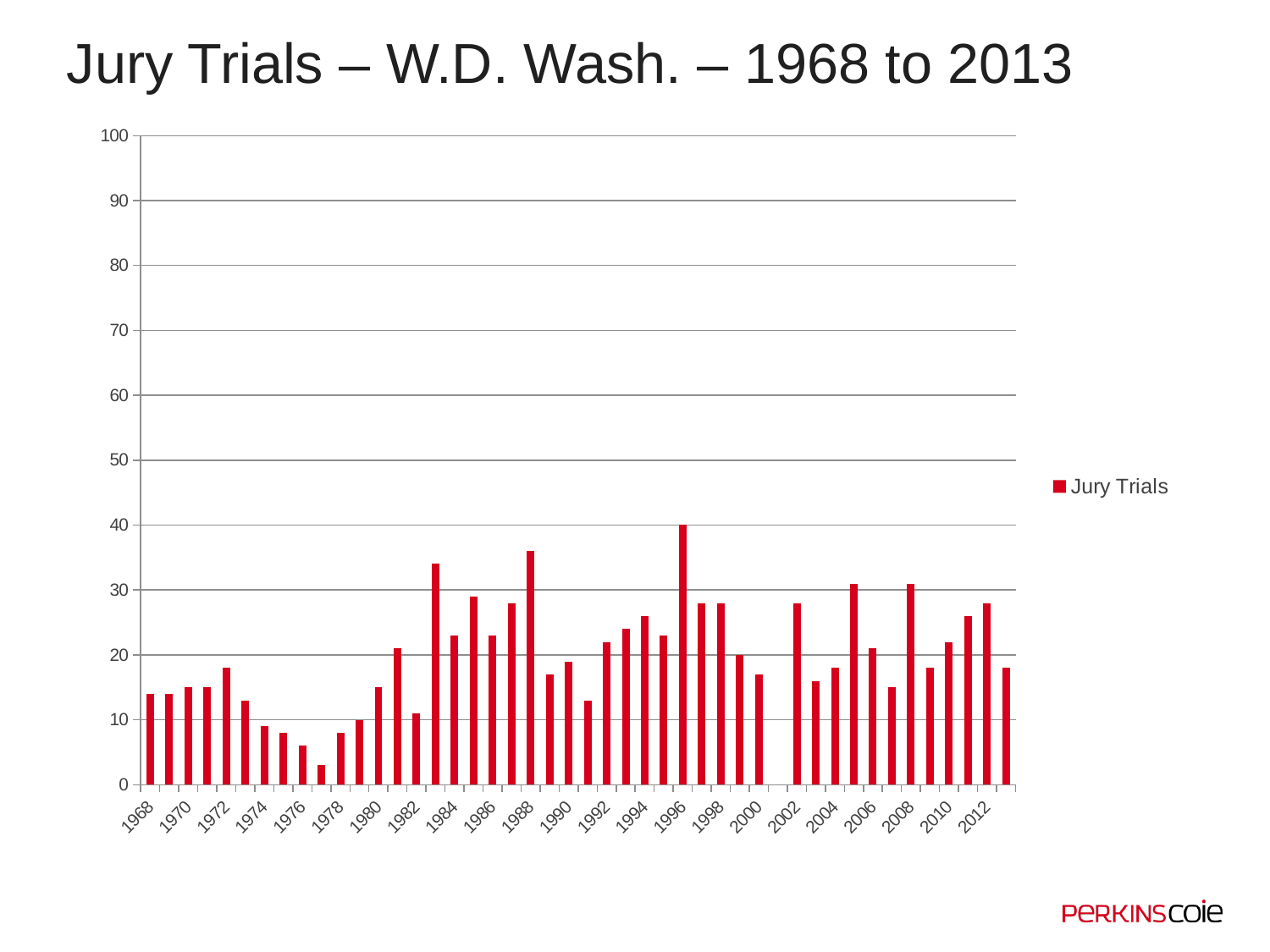
Is the value for 1988 greater or less than 30? greater Which is larger, the value for 2011 or the value for 2013? 2011 What is the name of the series shown in the legend? Jury Trials What kind of chart is shown on the slide? Bar chart How many series does the legend list? 1 Is the value for 1994 greater or less than 20? greater Which year has the highest number of jury trials? 1996 What is the value for 1996? 40 Which is larger, the value for 1996 or the value for 1988? 1996 Is the value for 1977 greater or less than 10? less Do the values rise or fall from 1973 to 1977? fall What is the title of the chart? Jury Trials – W.D. Wash. – 1968 to 2013